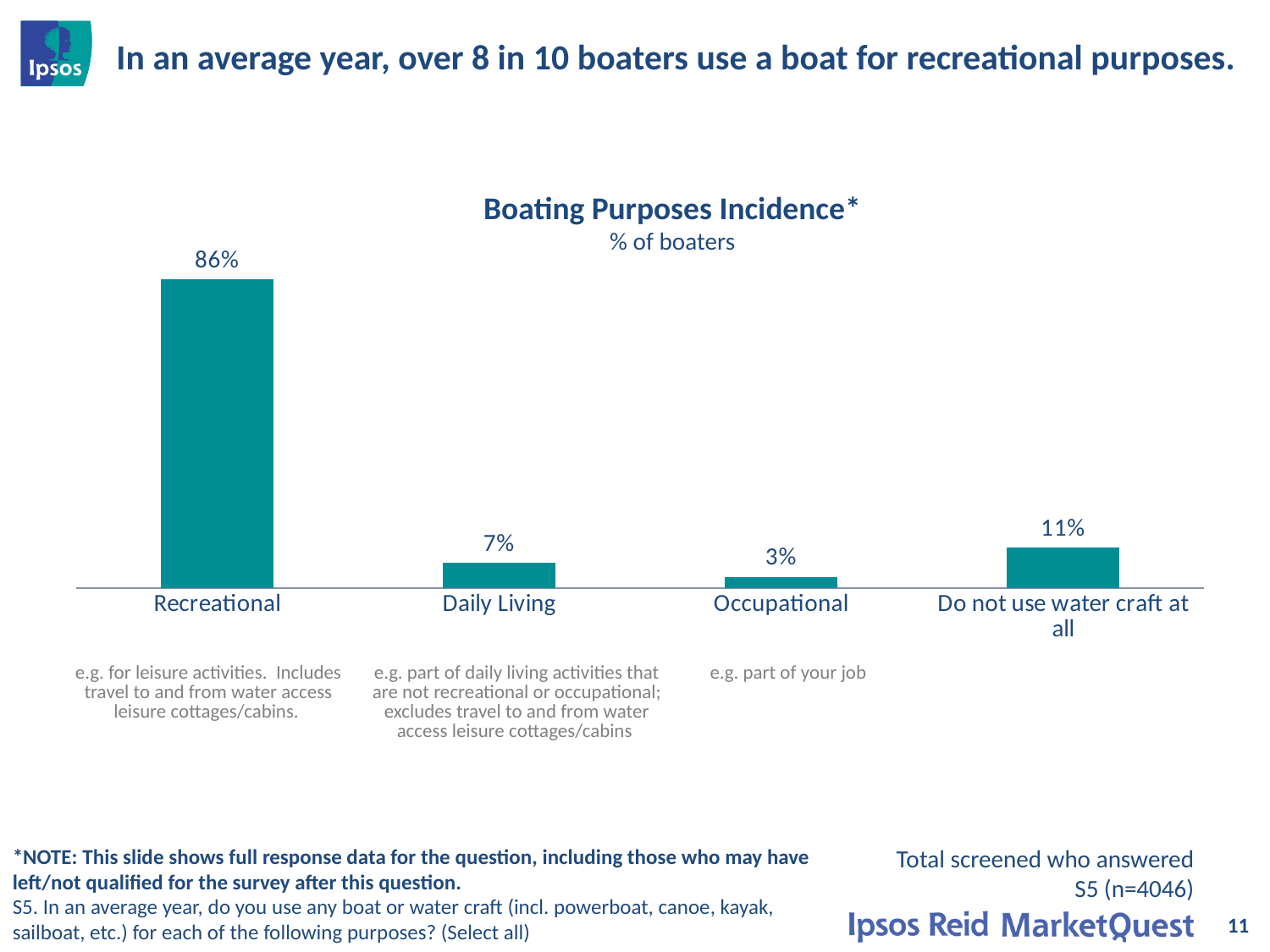
What is the difference between the values for Daily Living and Occupational? 4% What is the value for Occupational? 3% What kind of chart is shown on the slide? Bar chart What is the value for Recreational? 86% What is the value for Daily Living? 7% Which is larger, the value for Daily Living or the value for Do not use water craft at all? Do not use water craft at all How many categories are shown in the chart? 4 Which category has the highest value? Recreational What is the value for Do not use water craft at all? 11% Which category has the lowest value? Occupational What is the difference between the values for Recreational and Do not use water craft at all? 75% What is the title of the chart? Boating Purposes Incidence*